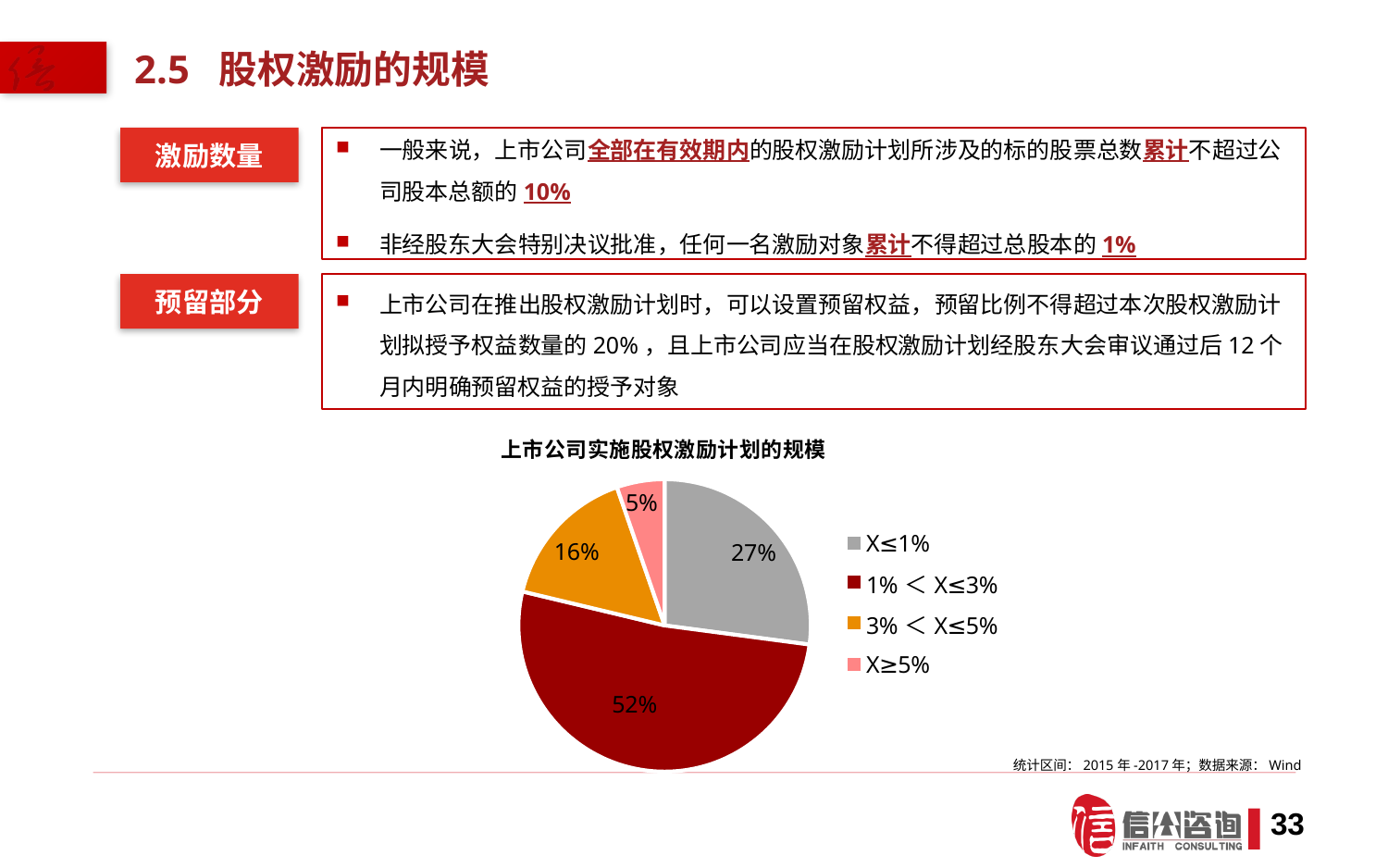
How many slices does the pie chart have? 4 What share of the pie does the 1%＜X≤3% category take? 52% What is the title of the chart? 上市公司实施股权激励计划的规模 Which has a larger share, X≤1% or 3%＜X≤5%? X≤1% What kind of chart is shown on the slide? pie chart Which category has the smallest share of the pie? X≥5% What share of the pie does the X≤1% category take? 27% What share of the pie does the 3%＜X≤5% category take? 16% Which category has the largest share of the pie? 1%＜X≤3% How many entries does the legend list? 4 What is the difference in share between the 1%＜X≤3% category and the X≤1% category? 25%